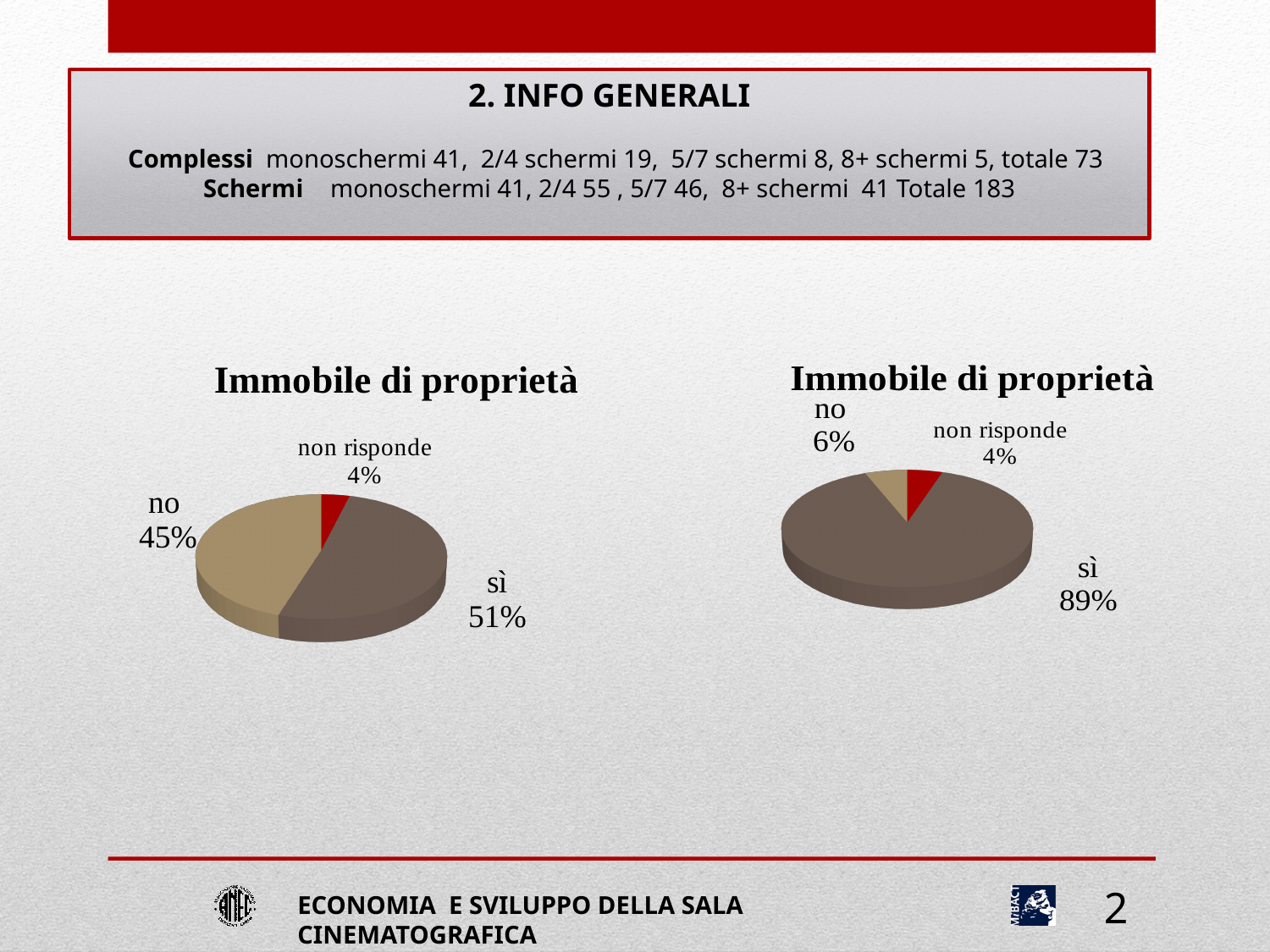
In the left pie chart, what is the difference between the shares for 'sì' and 'no'? 6% In the left pie chart titled 'Immobile di proprietà', what is the share for 'sì'? 51% In the left pie chart, which category has the smallest share? non risponde In the left pie chart, which category has the largest share? sì In the right pie chart titled 'Immobile di proprietà', what is the share for 'sì'? 89% In the right pie chart titled 'Immobile di proprietà', what is the share for 'non risponde'? 4% In the right pie chart, what is the difference between the shares for 'sì' and 'no'? 83% What type of chart is used on the right side of the slide? Pie chart How many slices does the left pie chart have? 3 In the right pie chart, which category has the largest share? sì In the left pie chart titled 'Immobile di proprietà', what is the share for 'no'? 45% In the right pie chart titled 'Immobile di proprietà', what is the share for 'no'? 6%